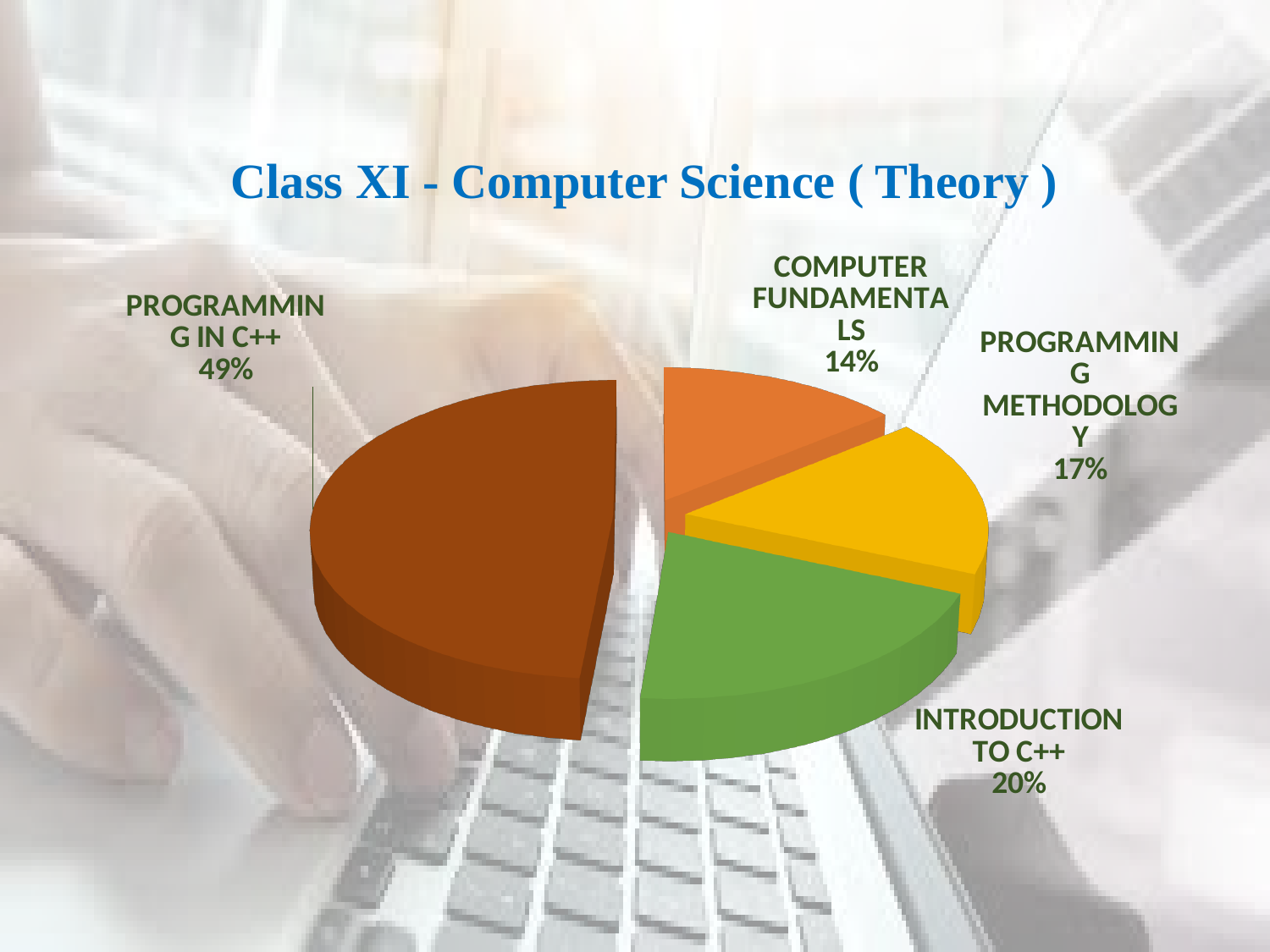
Which slice of the pie is the largest? Programming in C++ Which is larger, Programming Methodology or Computer Fundamentals? Programming Methodology What share of the pie does Programming in C++ have? 49% How many slices does the pie chart have? 4 Which slice of the pie is the smallest? Computer Fundamentals What is the title of the slide containing the pie chart? Class XI - Computer Science ( Theory ) What share of the pie does Computer Fundamentals have? 14% What share of the pie does Programming Methodology have? 17% What share of the pie does Introduction to C++ have? 20% What colour is the Introduction to C++ slice? Green What kind of chart is shown on the slide? Pie chart What is the difference in percentage points between Programming in C++ and Introduction to C++? 29